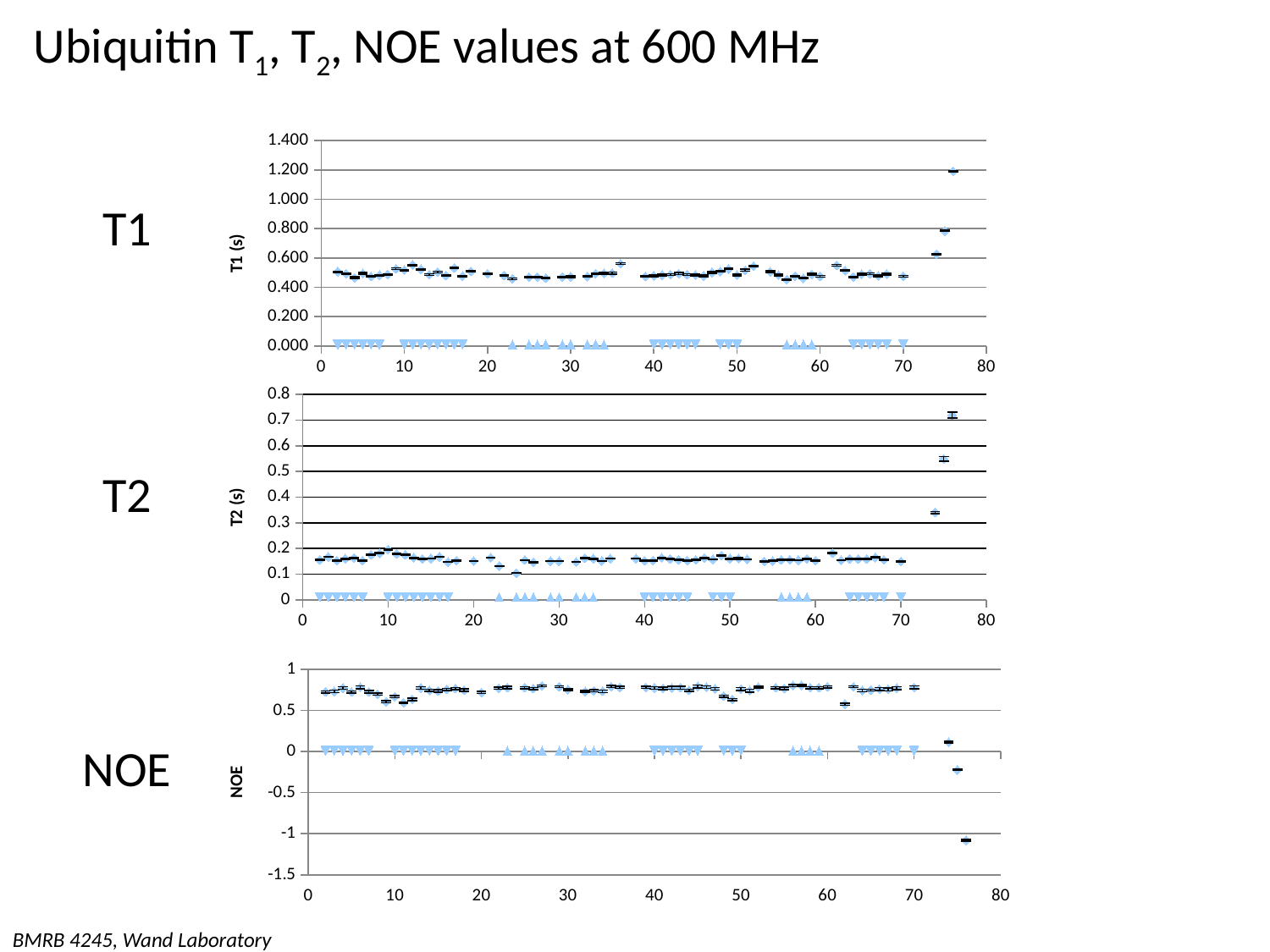
What is the highest tick value on the y axis of the T1 chart? 1.400 In the T1 chart, is the highest plotted value greater or less than 1.000? greater In the NOE chart, is the lowest plotted value greater or less than -1? less In the NOE chart, do the values rise or fall at the far right of the x axis (beyond 70)? fall In the T2 chart, are the values for x between 0 and 70 mostly greater or less than 0.2? less What is the y-axis label of the top chart? T1 (s) How many charts are shown on the slide? 3 In the T1 chart, do the values rise or fall at the far right of the x axis (beyond 70)? rise What kind of chart is the T1 chart? scatter chart